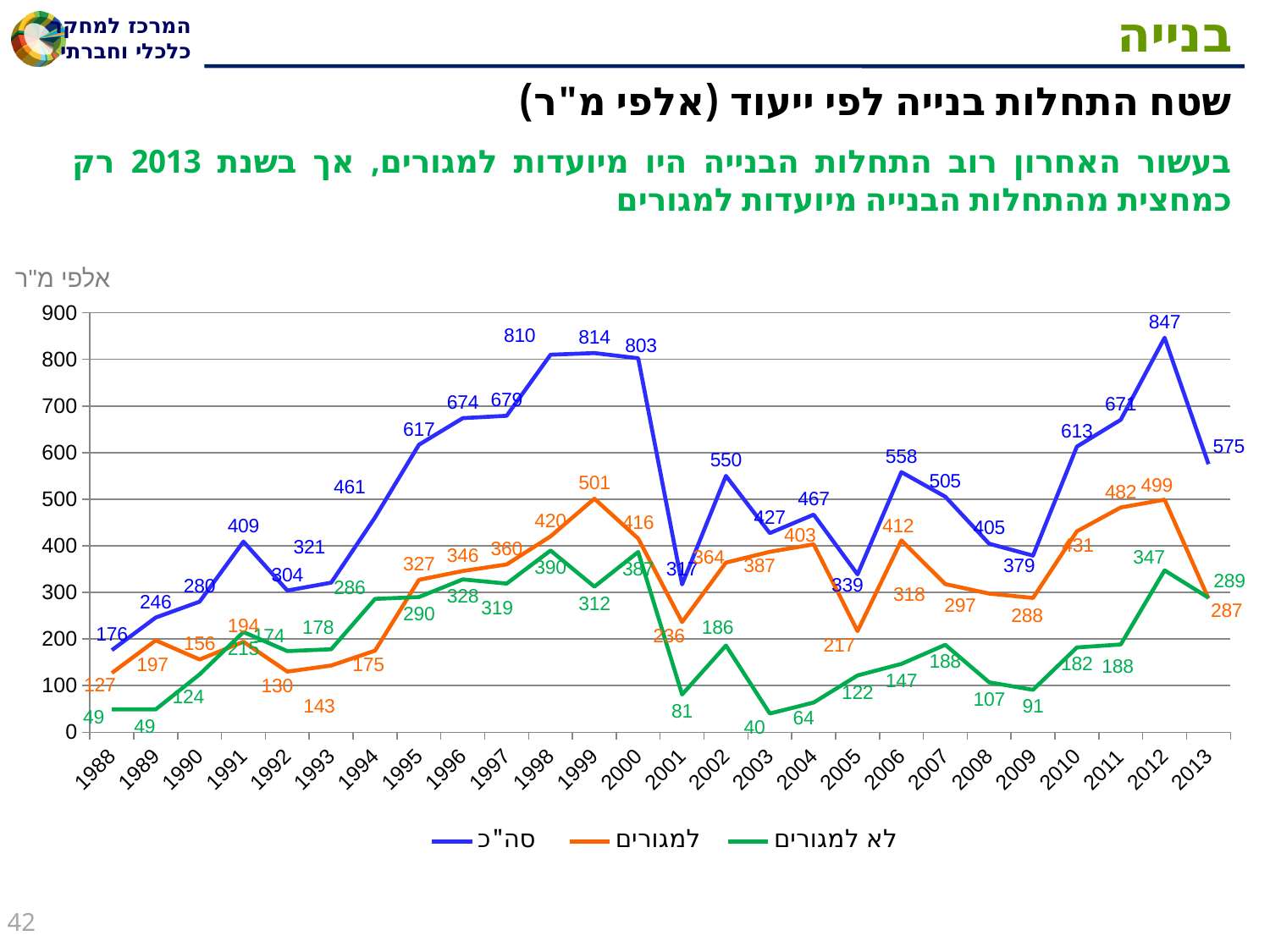
What is the value of the למגורים series in 1999? 501 What is the difference between the למגורים value in 2012 and in 2013? 212 In which year does the סה"כ series reach its highest value? 2012 What is the unit label shown above the y axis? אלפי מ"ר In which year does the לא למגורים series reach its lowest value? 2003 Does the סה"כ series rise or fall from 2012 to 2013? fall What kind of chart is shown on the slide? line chart What is the value of the סה"כ series in 2012? 847 Which is larger in 2013: the למגורים value or the לא למגורים value? לא למגורים How many series does the legend list? 3 How many years are plotted along the x axis? 26 What is the value of the לא למגורים series in 2003? 40